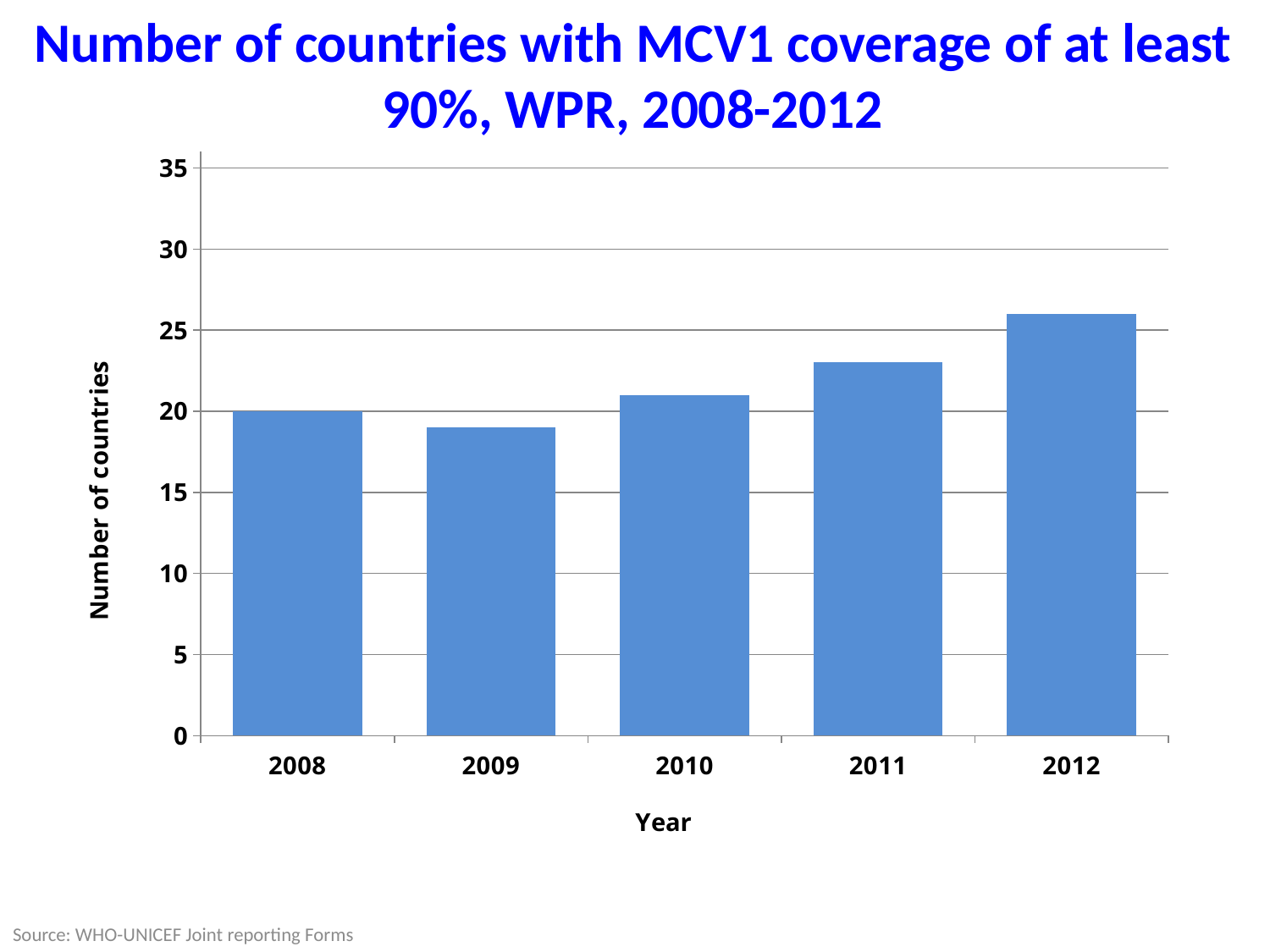
Which year has the larger value, 2011 or 2009? 2011 What type of chart is shown on the slide? Bar chart What is the label of the y axis? Number of countries Is the value for 2010 greater or less than 20? greater Is the value for 2012 greater or less than 25? greater How many years are shown on the x axis of the chart? 5 Is the value for 2011 greater or less than 25? less Which year has the larger value, 2012 or 2008? 2012 What is the title of the chart? Number of countries with MCV1 coverage of at least 90%, WPR, 2008-2012 Which year has the highest number of countries with MCV1 coverage of at least 90%? 2012 What is the number of countries with MCV1 coverage of at least 90% in 2008? 20